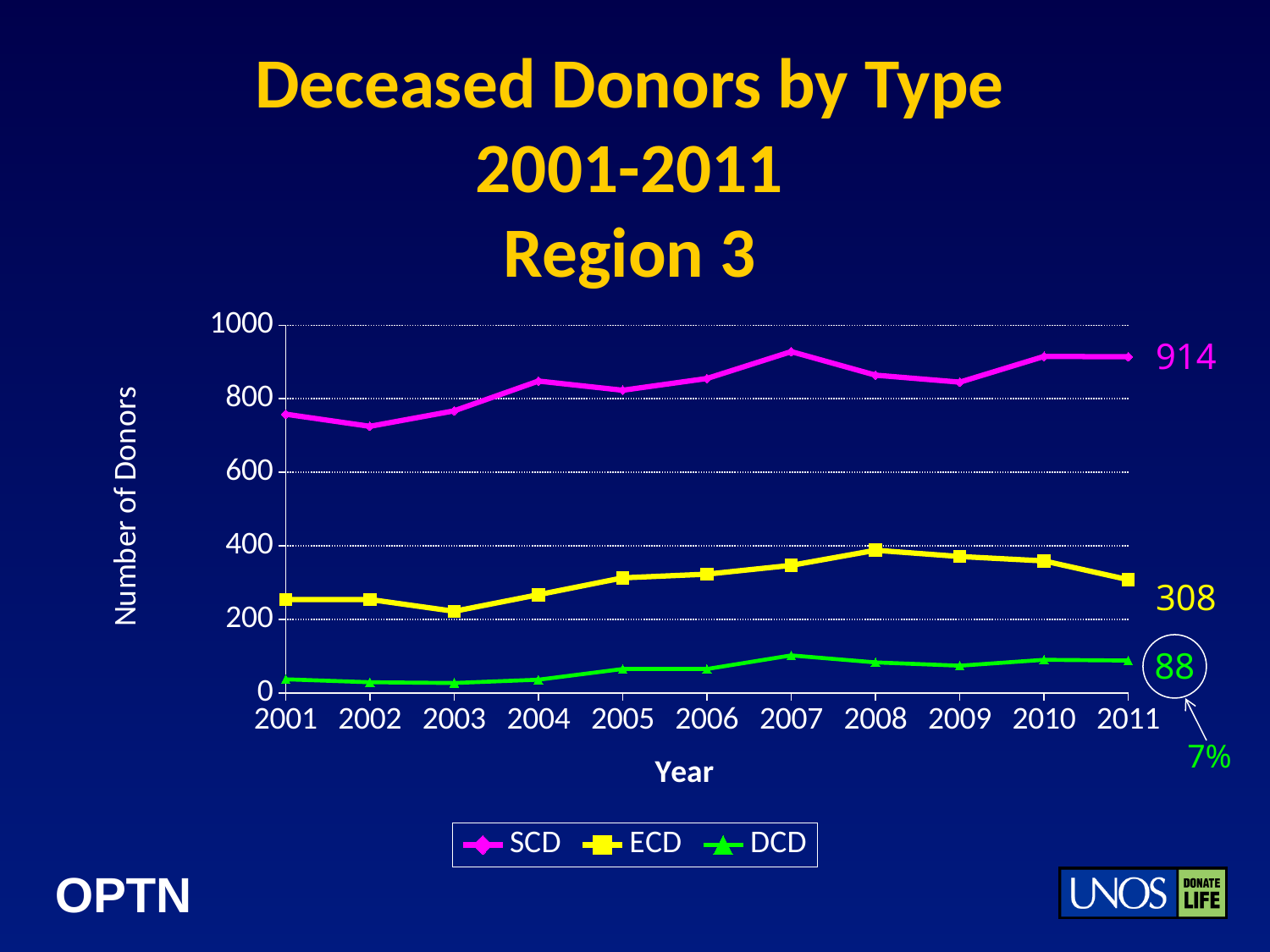
How many years are shown on the x axis? 11 Which series has the highest value in 2011? SCD Is the value for SCD in 2002 greater or less than 800? less What is the value for ECD in 2011? 308 What kind of chart is shown on the slide? line chart What is the difference between the ECD and DCD values in 2011? 220 What is the difference between the SCD and ECD values in 2011? 606 Which series has the lowest value in 2011? DCD What is the value for SCD in 2011? 914 How many series does the legend list? 3 Is the value for ECD in 2005 greater or less than 200? greater What is the value for DCD in 2011? 88